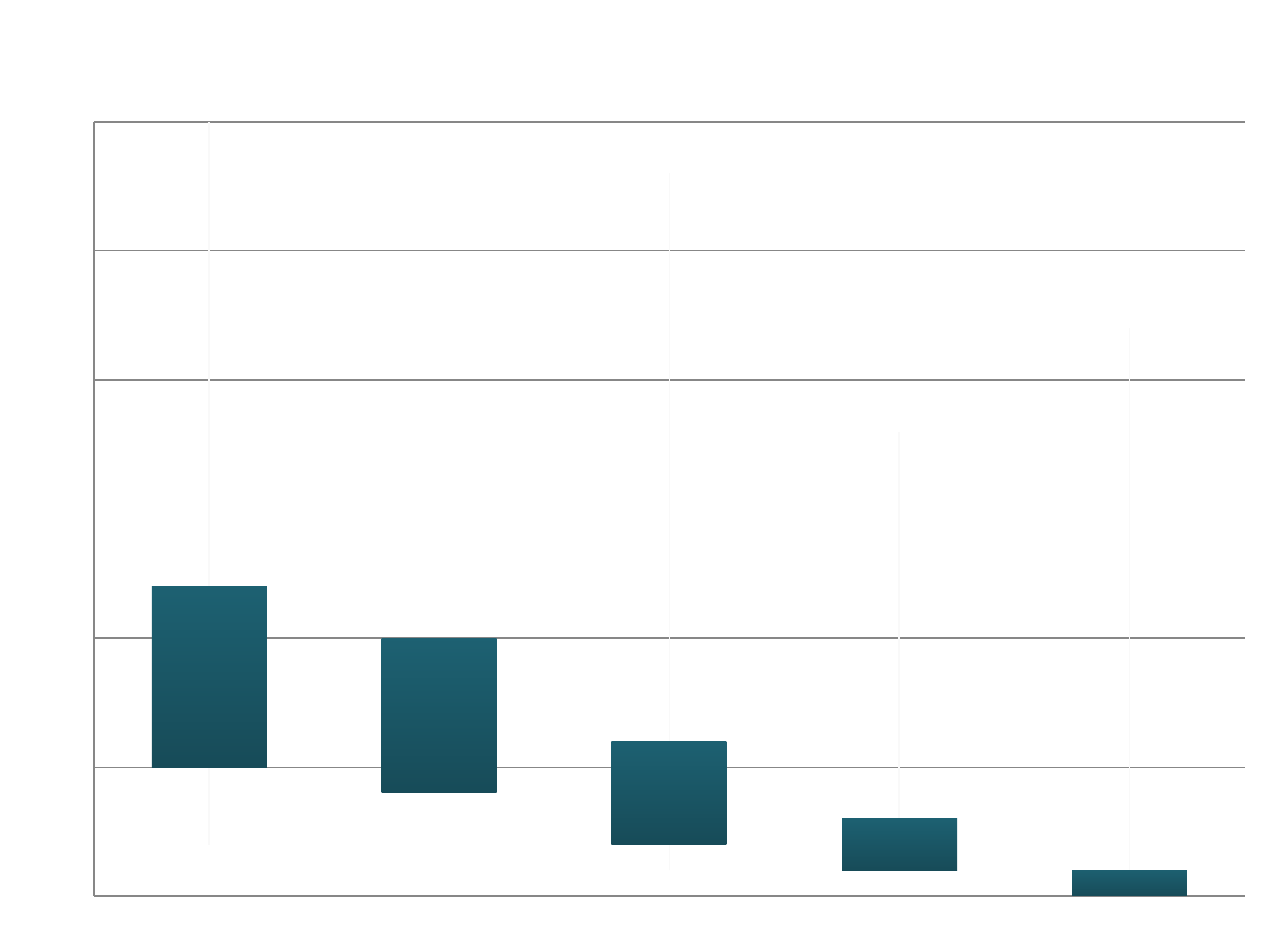
Does the chart display a legend? No Do the bars rise or fall from left to right across the chart? fall How many bars are plotted in the chart? 5 Which bar is the tallest: the leftmost bar or the rightmost bar? the leftmost bar What colour are the bars in the chart? dark teal What kind of chart is shown on the slide? bar chart